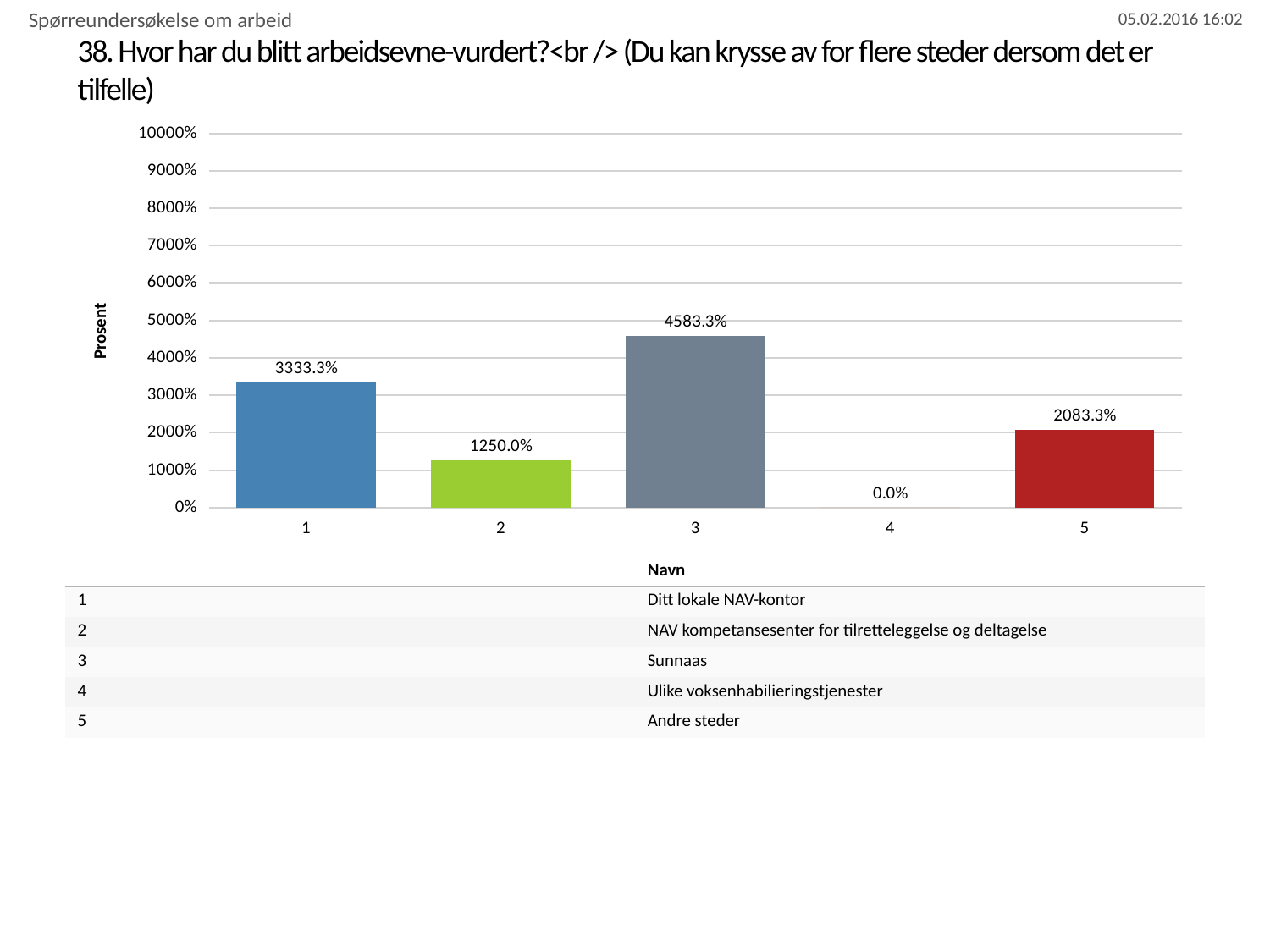
What is the value for category 5 (Andre steder)? 2083.3% Which category has the highest value? 3 What is the label of the y axis? Prosent What is the value for category 3 (Sunnaas)? 4583.3% Is the value for category 2 greater or less than 2000%? less What kind of chart is shown on the slide? bar chart Which is larger, the value for category 2 or the value for category 5? 5 How many categories are shown on the x axis? 5 What is the difference between the values for category 3 and category 1? 1250.0% Which category has the lowest value? 4 What is the value for category 1 (Ditt lokale NAV-kontor)? 3333.3% What is the value for category 4 (Ulike voksenhabilieringstjenester)? 0.0%